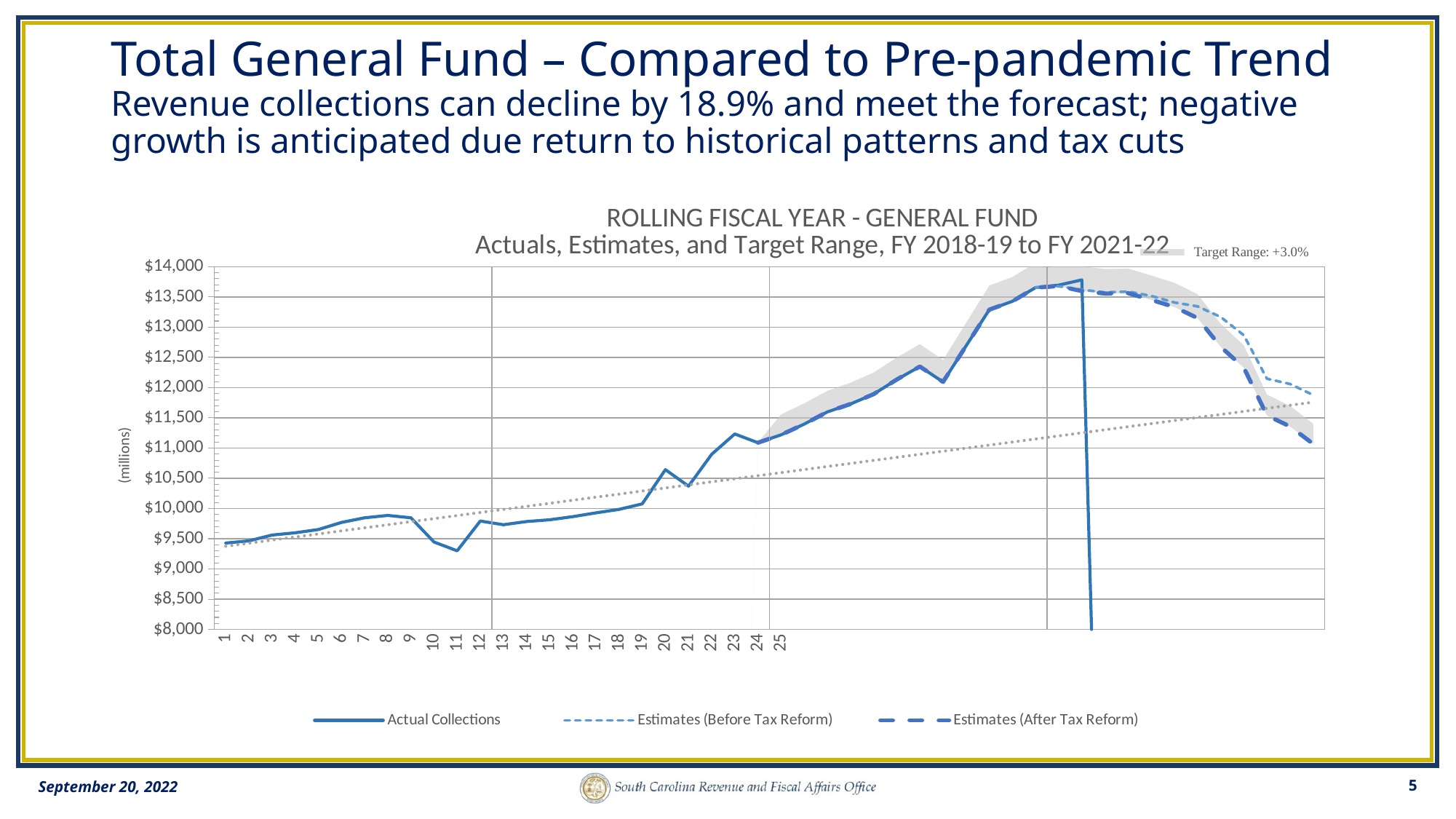
Do Actual Collections rise or fall from point 9 to point 11? fall Is the Actual Collections value at point 11 greater or less than $9,500? less Among the labeled points 1 to 25, at which point is Actual Collections lowest? 11 Which is larger for Actual Collections: the value at point 20 or the value at point 21? point 20 Is the Actual Collections value at point 20 greater or less than $10,500? greater What unit is shown on the vertical axis label of the chart? (millions) Which is larger for Actual Collections: the value at point 8 or the value at point 11? point 8 Is the Actual Collections value at point 23 greater or less than $11,000? greater What kind of chart is shown on the slide? line chart How many series does the chart legend list? 3 What is the title of the chart? ROLLING FISCAL YEAR - GENERAL FUND Actuals, Estimates, and Target Range, FY 2018-19 to FY 2021-22